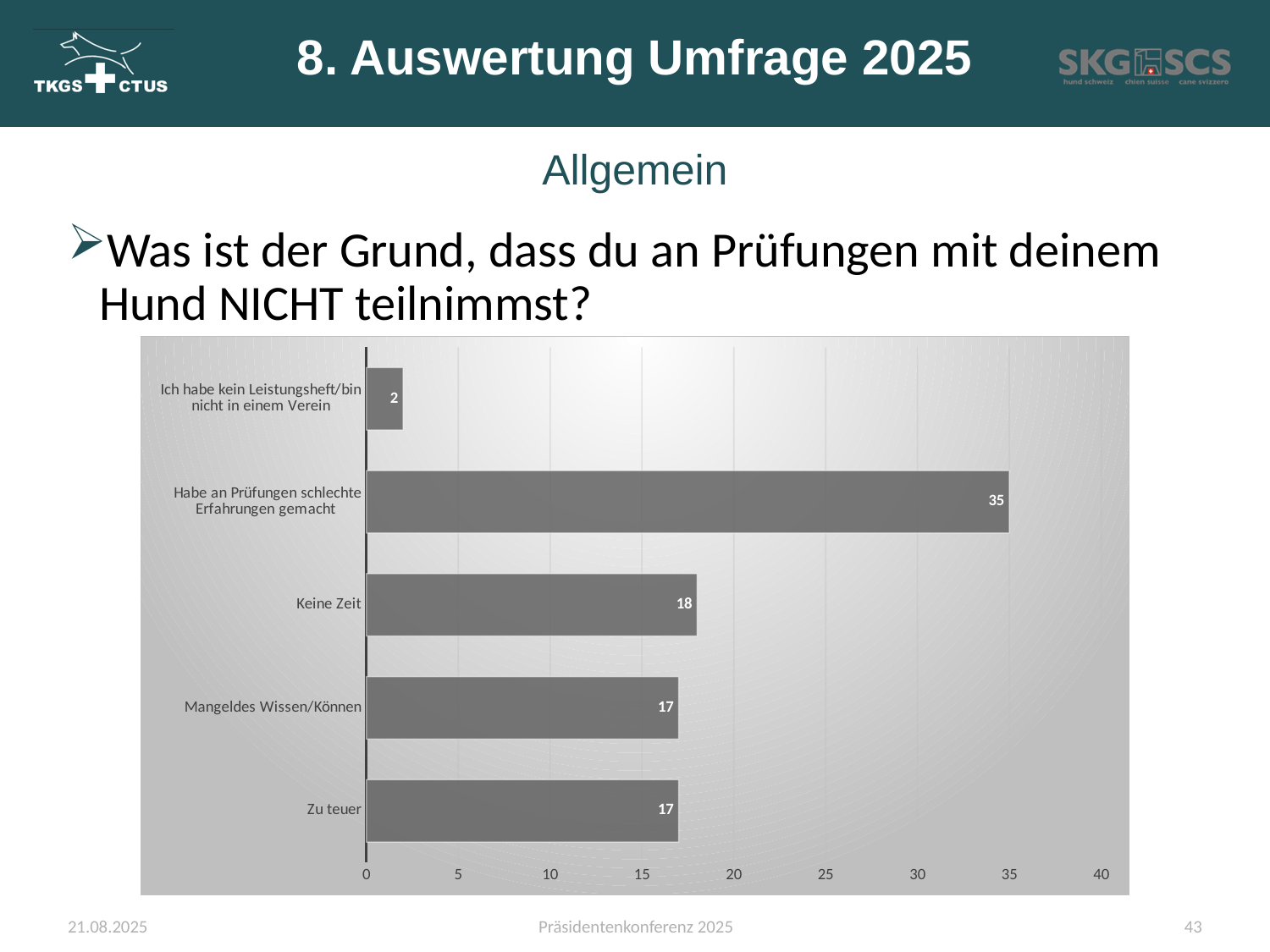
What is the highest value shown on the x axis? 40 Is the value for "Habe an Prüfungen schlechte Erfahrungen gemacht" greater or less than 30? greater Which category has the lowest value? Ich habe kein Leistungsheft/bin nicht in einem Verein What is the difference between the values for "Habe an Prüfungen schlechte Erfahrungen gemacht" and "Keine Zeit"? 17 What is the value for "Habe an Prüfungen schlechte Erfahrungen gemacht"? 35 Which is larger, the value for "Keine Zeit" or the value for "Mangeldes Wissen/Können"? Keine Zeit What is the value for "Keine Zeit"? 18 What is the value for "Ich habe kein Leistungsheft/bin nicht in einem Verein"? 2 What is the value for "Zu teuer"? 17 What kind of chart is shown on the slide? bar chart How many categories are shown in the chart? 5 Which category has the highest value? Habe an Prüfungen schlechte Erfahrungen gemacht